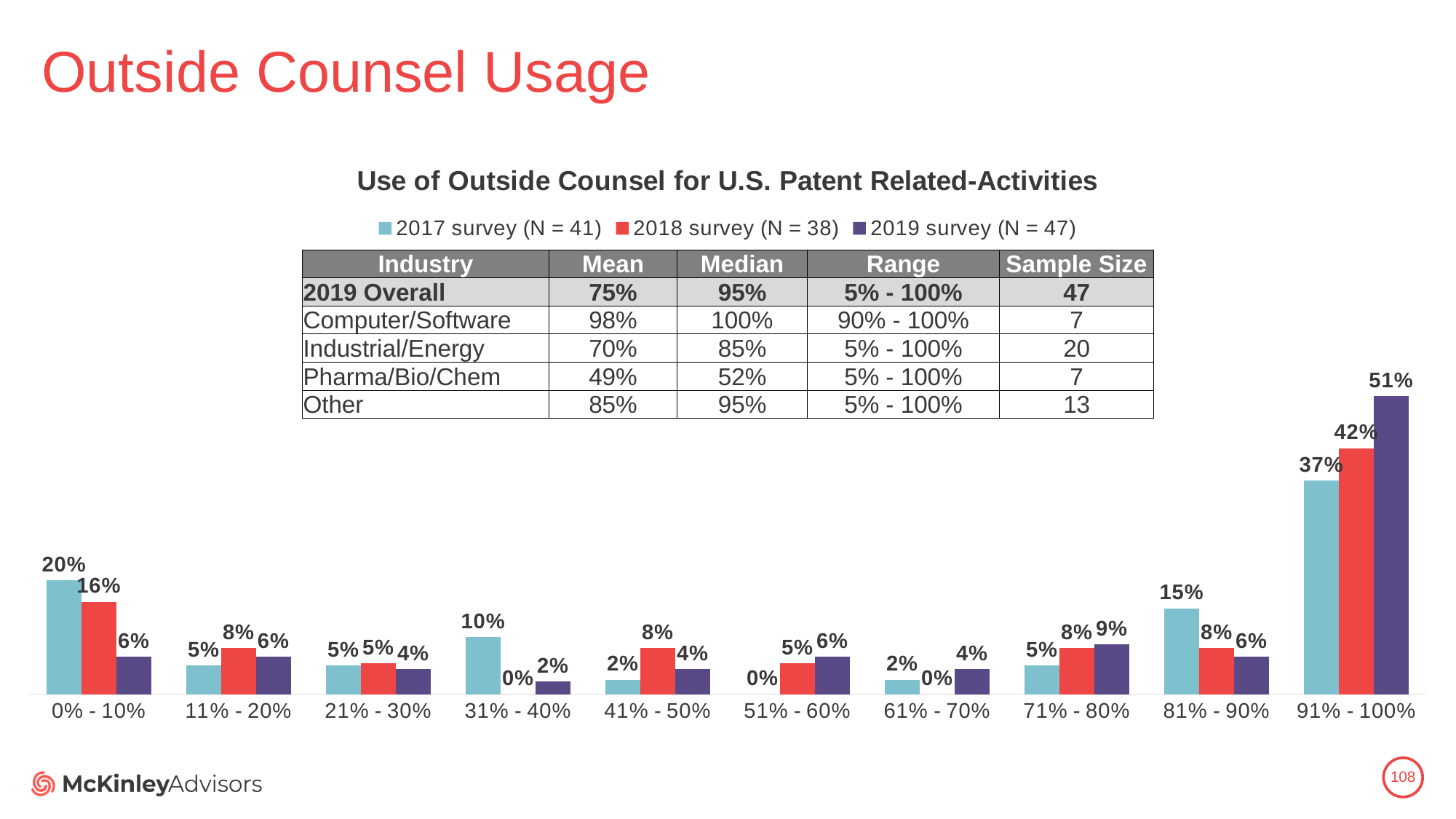
What kind of chart is shown on the slide? Bar chart Which is larger in the 31% - 40% category, the 2017 survey value or the 2019 survey value? 2017 survey What is the value for the 2017 survey in the 0% - 10% category? 20% What is the value for the 2018 survey in the 41% - 50% category? 8% What is the difference between the 2019 survey and the 2017 survey values in the 91% - 100% category? 14% What is the value for the 2019 survey in the 91% - 100% category? 51% How many series does the legend list? 3 What is the title of the chart? Use of Outside Counsel for U.S. Patent Related-Activities Which category has the highest value for the 2019 survey? 91% - 100% How many categories are shown on the x axis of the chart? 10 What is the value for the 2017 survey in the 81% - 90% category? 15% What is the difference between the 2017 survey and the 2019 survey values in the 0% - 10% category? 14%